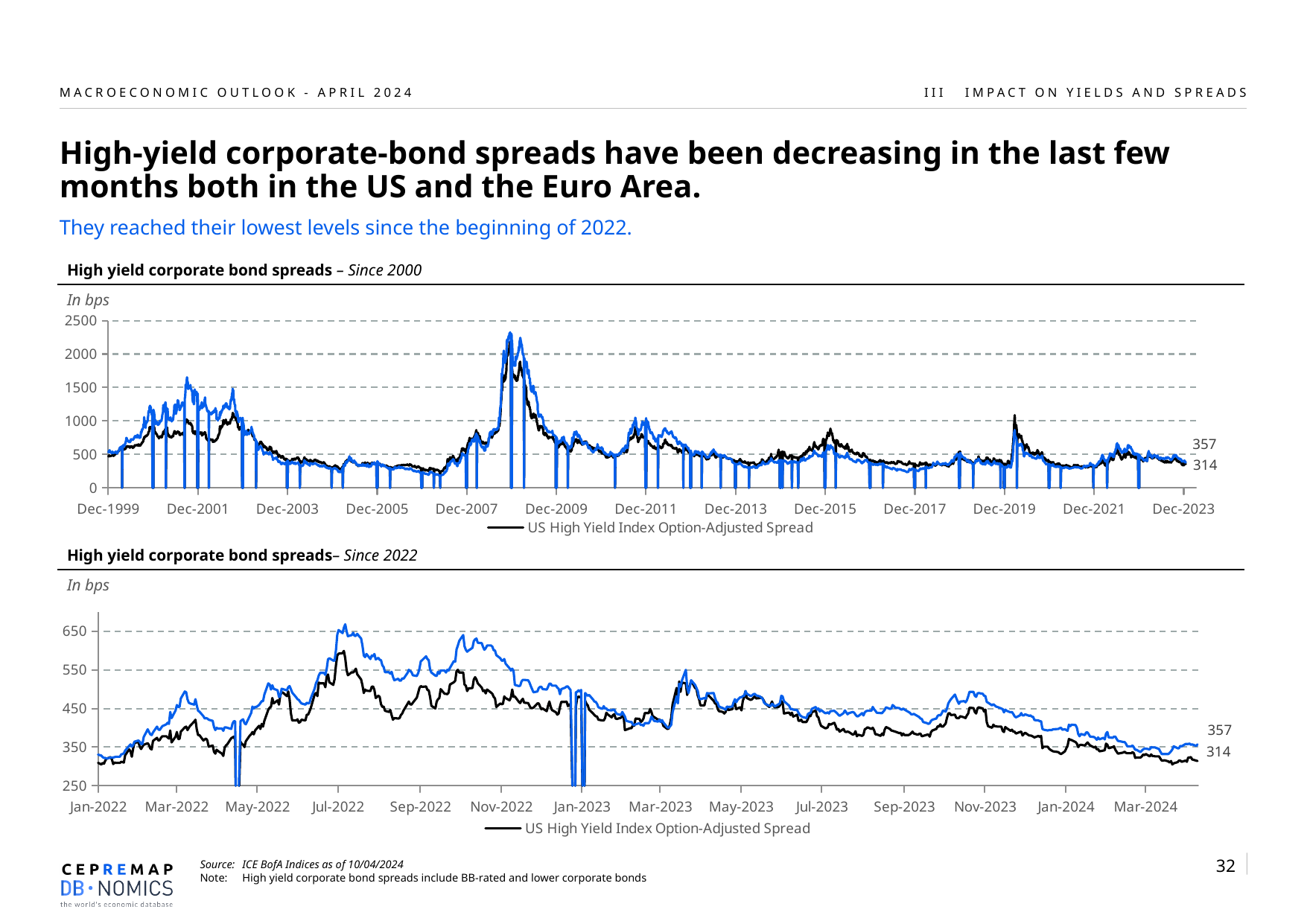
In the 'High yield corporate bond spreads – Since 2022' chart, what value is labelled at the right end of the blue line? 357 How many series does the legend of the 'High yield corporate bond spreads – Since 2022' chart list? 1 In the 'High yield corporate bond spreads – Since 2000' chart, what is the highest value shown on the vertical axis? 2500 In the 'High yield corporate bond spreads – Since 2022' chart, is the US High Yield Index Option-Adjusted Spread at Jan-2022 greater or less than 350? less In the 'High yield corporate bond spreads – Since 2022' chart, which line ends higher at the right edge, the blue line or the black US High Yield Index Option-Adjusted Spread line? the blue line In the 'High yield corporate bond spreads – Since 2000' chart, is the peak of the US High Yield Index Option-Adjusted Spread around Dec-2008 greater or less than 1500? greater In the 'High yield corporate bond spreads – Since 2022' chart, what is the difference between the two values labelled at the right end of the lines, 357 and 314? 43 In what unit are the values of the two charts expressed? bps What kind of chart is the 'High yield corporate bond spreads – Since 2000' chart? line chart How many charts are shown on the slide? 2 In the 'High yield corporate bond spreads – Since 2022' chart, what is the latest value labelled for the US High Yield Index Option-Adjusted Spread (black line)? 314 In the 'High yield corporate bond spreads – Since 2022' chart, do the spreads rise or fall between Nov-2023 and Mar-2024? fall